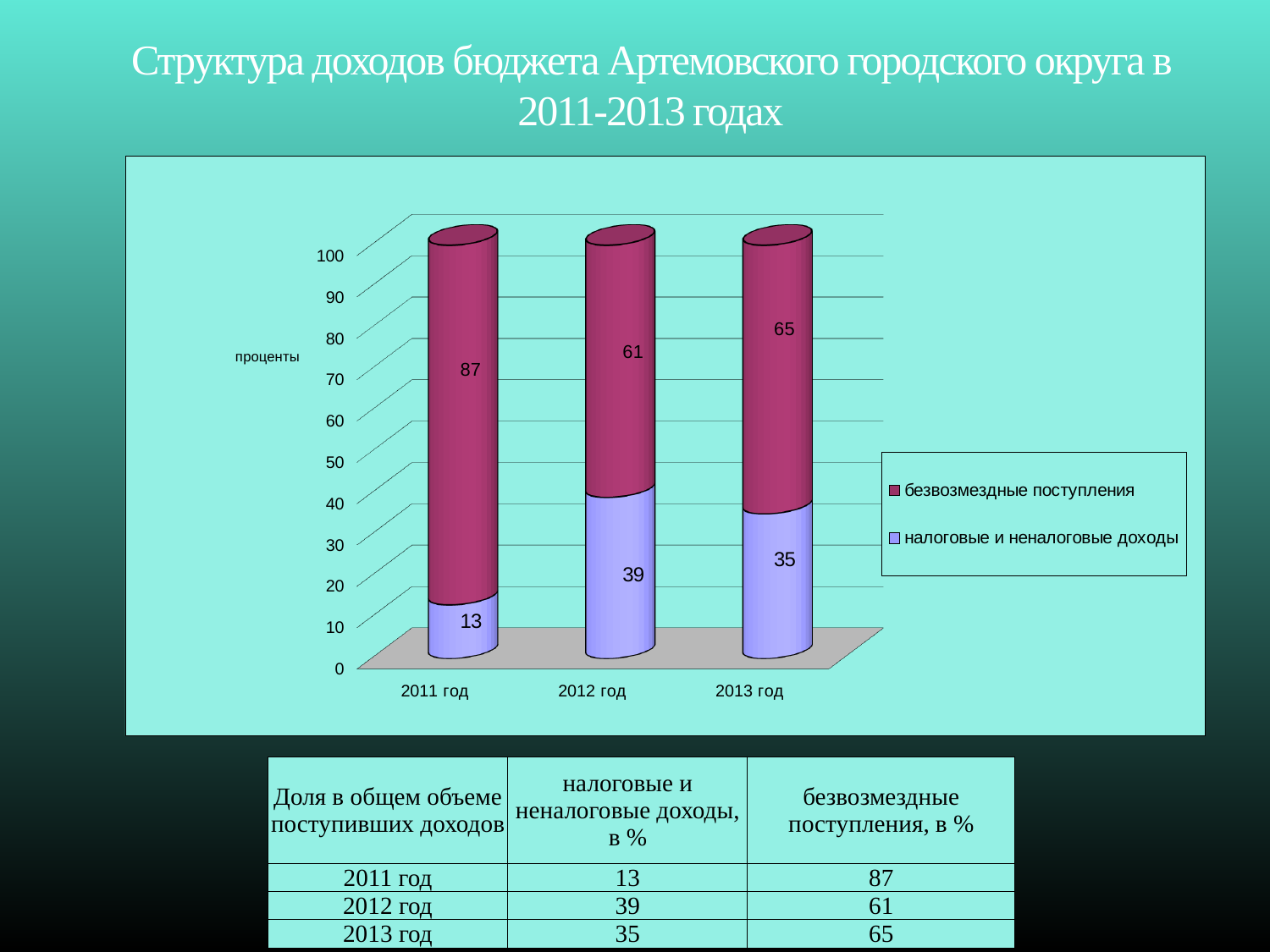
What is the label of the vertical axis? проценты What kind of chart is shown? stacked bar chart What is the difference between безвозмездные поступления in 2011 год and 2013 год? 22 What is the value for налоговые и неналоговые доходы in 2013 год? 35 What is the total of the stacked bar for 2012 год? 100 What is the value for безвозмездные поступления in 2011 год? 87 Which year has the lowest value for безвозмездные поступления? 2012 год What is the value for налоговые и неналоговые доходы in 2012 год? 39 How many series does the legend list? 2 Which is larger: налоговые и неналоговые доходы in 2012 год or in 2013 год? 2012 год Which year has the highest value for налоговые и неналоговые доходы? 2012 год How many years are shown on the x axis? 3